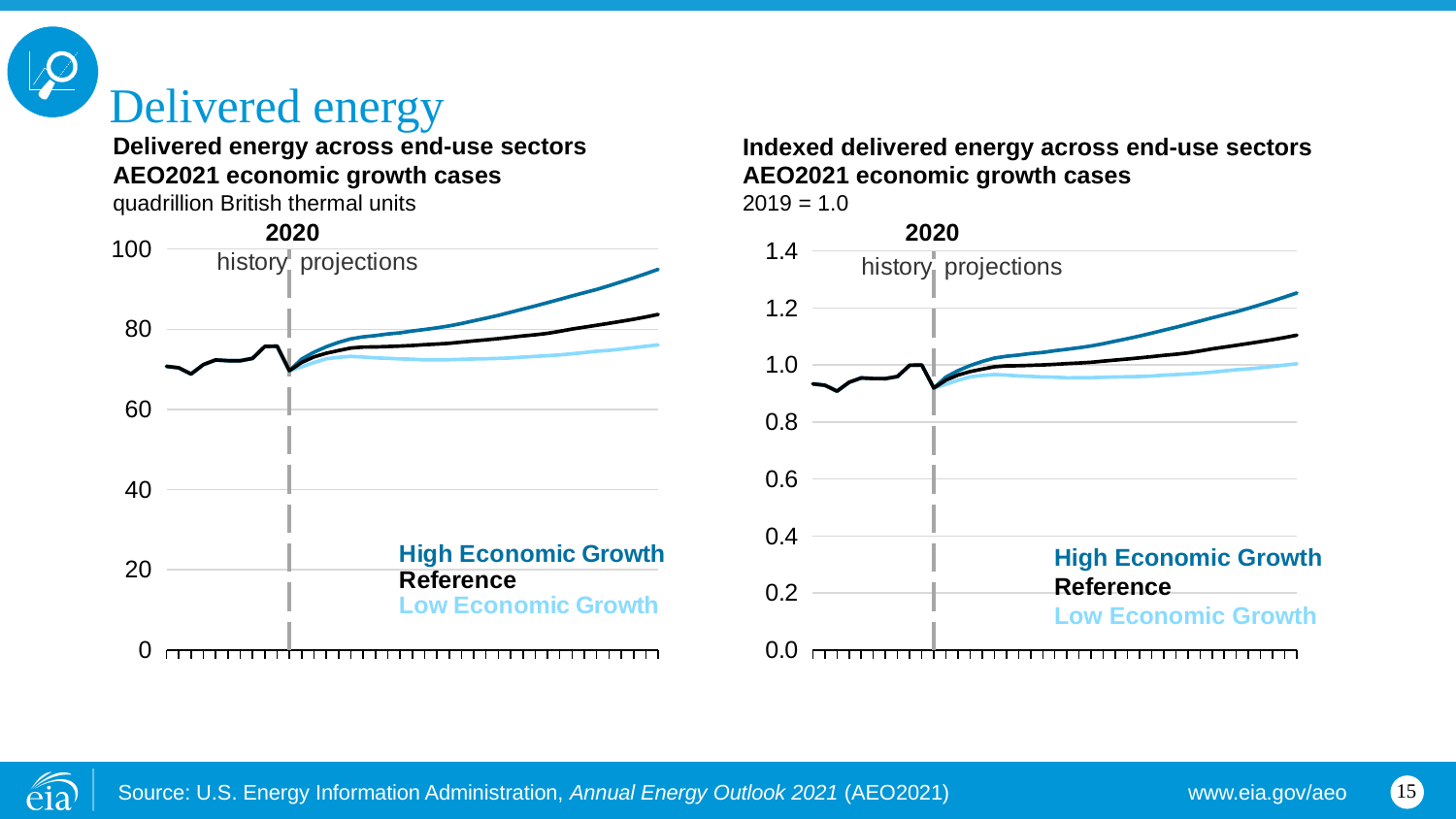
What unit is used on the y axis of the left chart, 'Delivered energy across end-use sectors'? quadrillion British thermal units Which year does the dashed vertical line separating history from projections mark in both charts? 2020 In the right chart, 'Indexed delivered energy across end-use sectors', which is larger at the end of the projection period: High Economic Growth or Low Economic Growth? High Economic Growth What kind of chart is the left chart, 'Delivered energy across end-use sectors'? line chart In the left chart, 'Delivered energy across end-use sectors', which series is highest at the end of the projection period? High Economic Growth In the left chart, 'Delivered energy across end-use sectors', is the Low Economic Growth value at the end of the projection period greater or less than 80? less In the left chart, 'Delivered energy across end-use sectors', does the High Economic Growth series rise or fall over the projection period? rise In the left chart, 'Delivered energy across end-use sectors', which series is lowest at the end of the projection period? Low Economic Growth How many series does the left chart, 'Delivered energy across end-use sectors', show? 3 In the left chart, 'Delivered energy across end-use sectors', is the High Economic Growth value at the end of the projection period greater or less than 80? greater In the right chart, 'Indexed delivered energy across end-use sectors', is the High Economic Growth value at the end of the projection period greater or less than 1.2? greater